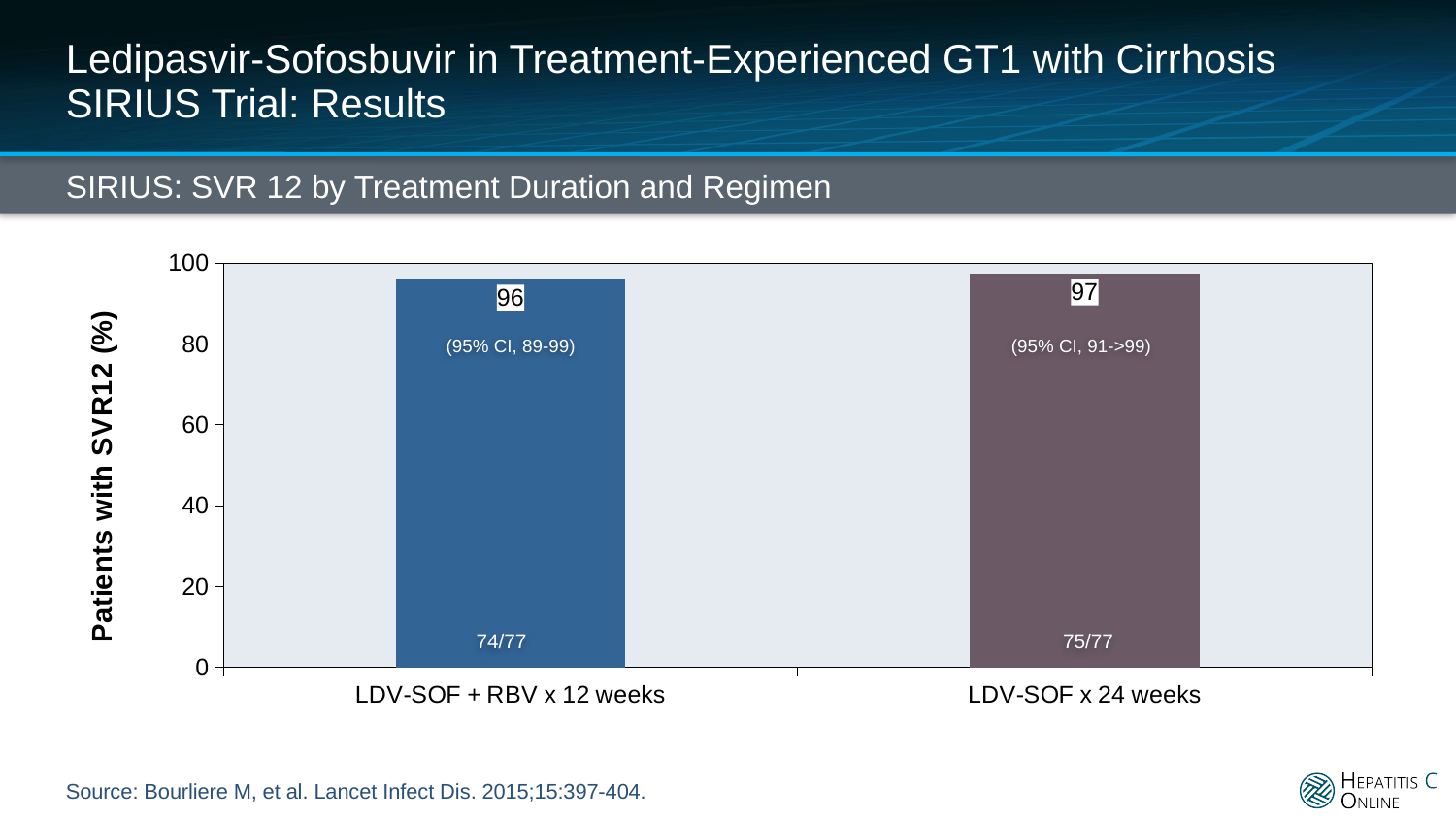
Which treatment regimen has the lower SVR12 rate? LDV-SOF + RBV x 12 weeks What fraction of patients achieved SVR12 in the LDV-SOF + RBV x 12 weeks group? 74/77 What is the SVR12 rate for LDV-SOF x 24 weeks? 97 What kind of chart is shown on the slide? bar chart What is the 95% confidence interval shown for LDV-SOF x 24 weeks? 91->99 Is the SVR12 rate for LDV-SOF + RBV x 12 weeks greater or less than 80? greater What is the label of the y-axis? Patients with SVR12 (%) How many treatment regimens are shown in the chart? 2 What is the SVR12 rate for LDV-SOF + RBV x 12 weeks? 96 What is the difference in SVR12 rate between LDV-SOF x 24 weeks and LDV-SOF + RBV x 12 weeks? 1 What fraction of patients achieved SVR12 in the LDV-SOF x 24 weeks group? 75/77 Which treatment regimen has the higher SVR12 rate? LDV-SOF x 24 weeks